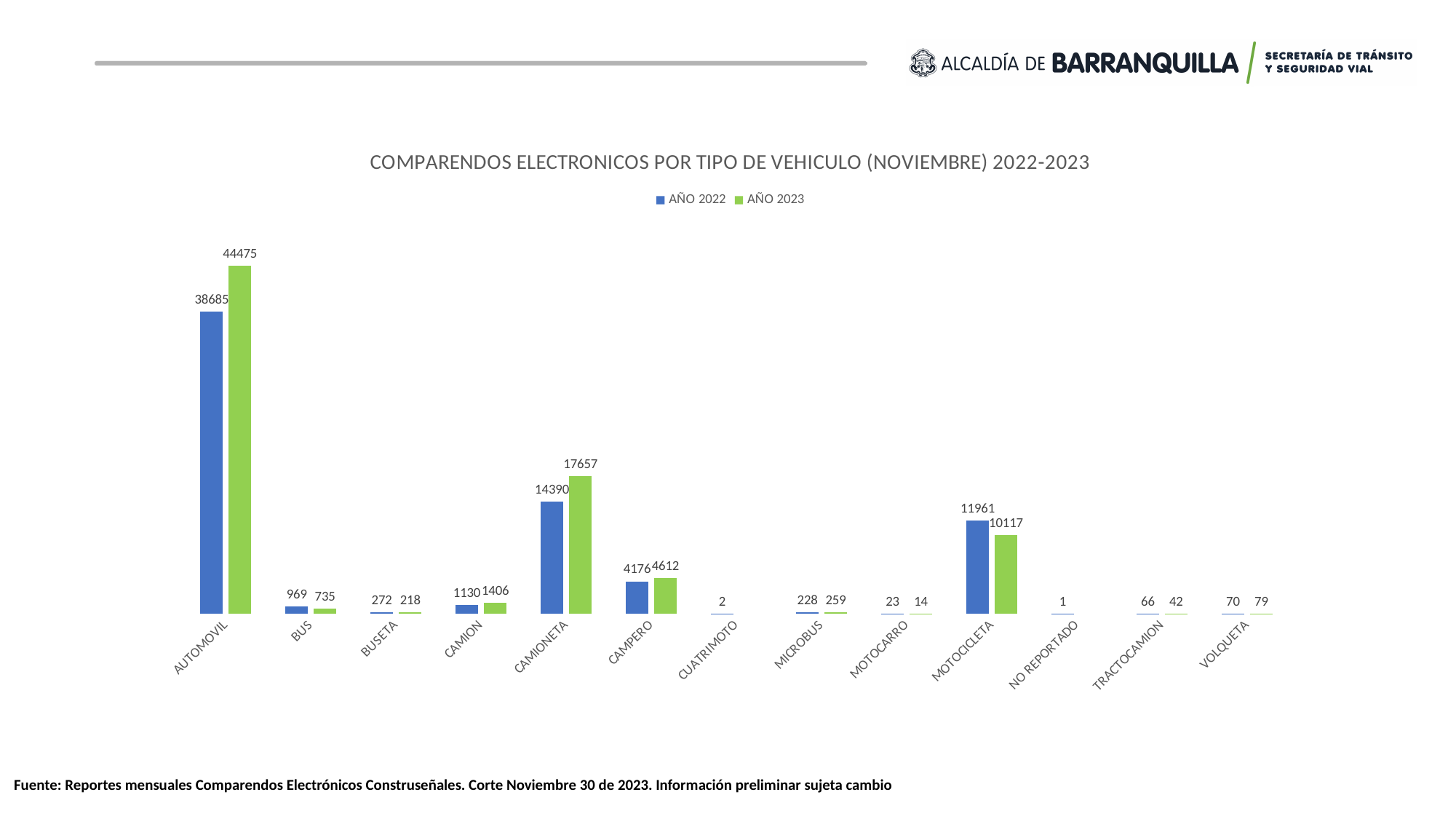
Which vehicle type has the highest value in AÑO 2022? AUTOMOVIL For BUS, which year has the larger value, AÑO 2022 or AÑO 2023? AÑO 2022 How many series does the legend list? 2 How many vehicle type categories are shown on the x axis? 13 What is the difference between the AÑO 2023 and AÑO 2022 values for AUTOMOVIL? 5790 What is the difference between the AÑO 2022 and AÑO 2023 values for MOTOCICLETA? 1844 What is the title of the chart? COMPARENDOS ELECTRONICOS POR TIPO DE VEHICULO (NOVIEMBRE) 2022-2023 What is the value for CAMIONETA in AÑO 2022? 14390 What is the value for MOTOCICLETA in AÑO 2023? 10117 What is the value for AUTOMOVIL in AÑO 2023? 44475 What type of chart is shown on the slide? Bar chart For CAMIONETA, which year has the larger value, AÑO 2022 or AÑO 2023? AÑO 2023